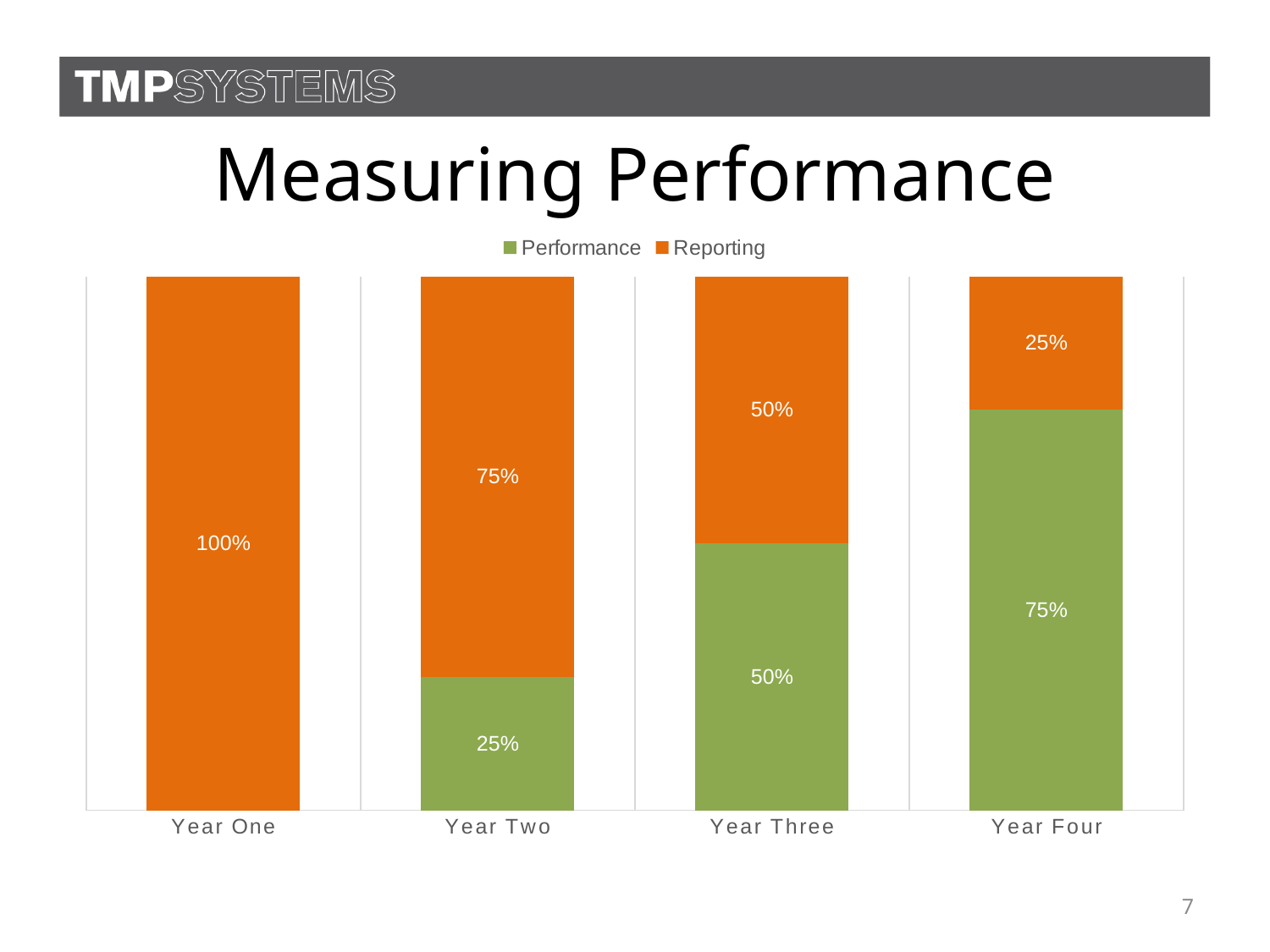
Which year has the highest Performance value? Year Four What is the difference between the Reporting value for Year Two and the Reporting value for Year Four? 50% How many years are shown on the x axis? 4 What is the Reporting value for Year One? 100% What kind of chart is shown on the slide? Stacked bar chart What is the Performance value for Year Two? 25% Which year has the lowest Reporting value? Year Four Which is larger for Year Two: Performance or Reporting? Reporting What is the Reporting value for Year Three? 50% How many series does the legend list? 2 Does the Performance value rise or fall from Year Two to Year Four? Rise What is the Performance value for Year Four? 75%